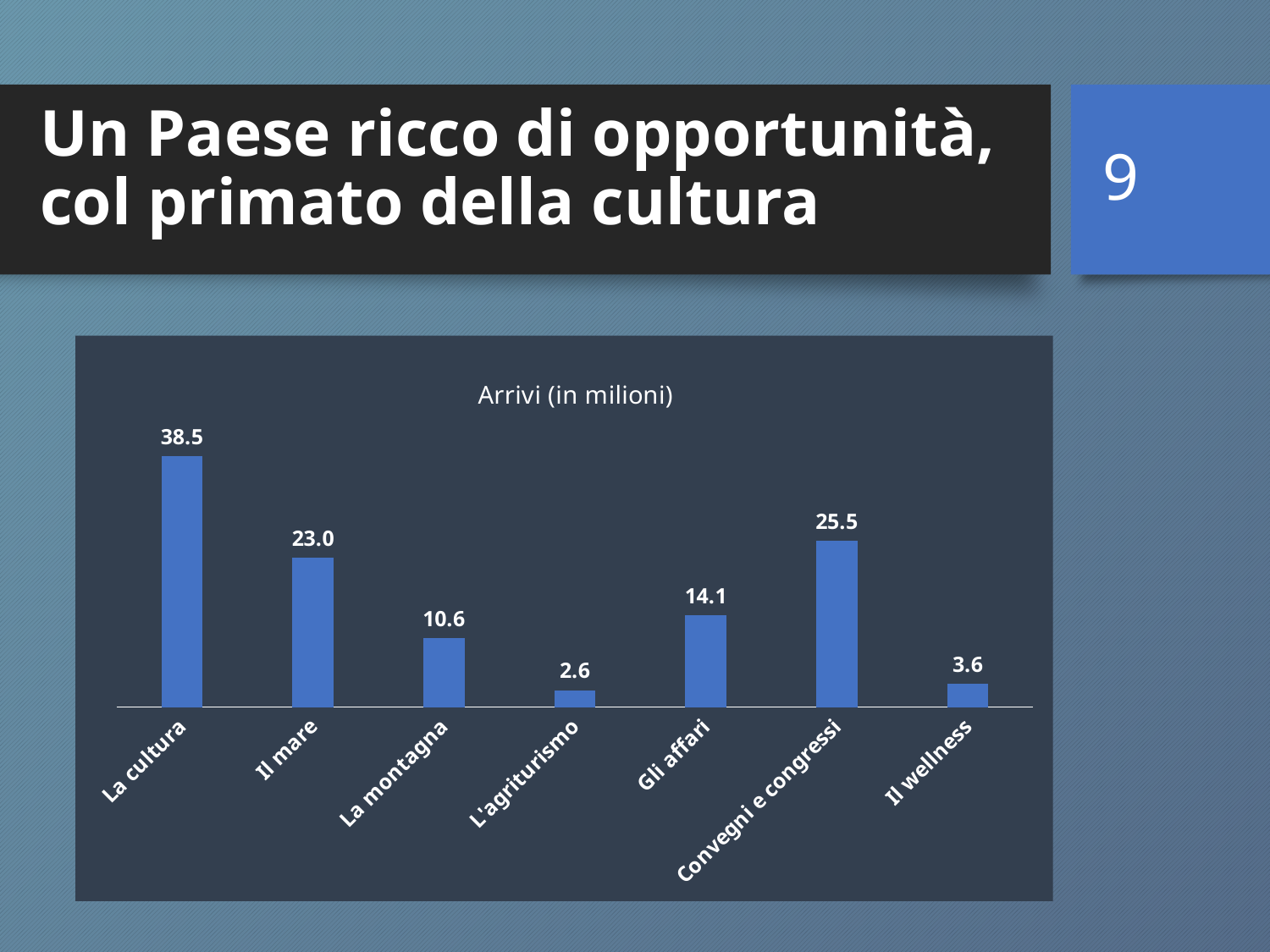
What is the difference between the values for La cultura and Il mare? 15.5 What is the value for L'agriturismo? 2.6 What kind of chart is shown on the slide? Bar chart What is the value for La cultura? 38.5 Which is larger, the value for Il mare or the value for Convegni e congressi? Convegni e congressi Which is larger, the value for Il wellness or the value for L'agriturismo? Il wellness Which category has the highest value? La cultura How many categories are shown in the chart? 7 What is the value for Convegni e congressi? 25.5 What is the difference between the values for Gli affari and La montagna? 3.5 Which category has the lowest value? L'agriturismo What is the title of the chart? Arrivi (in milioni)